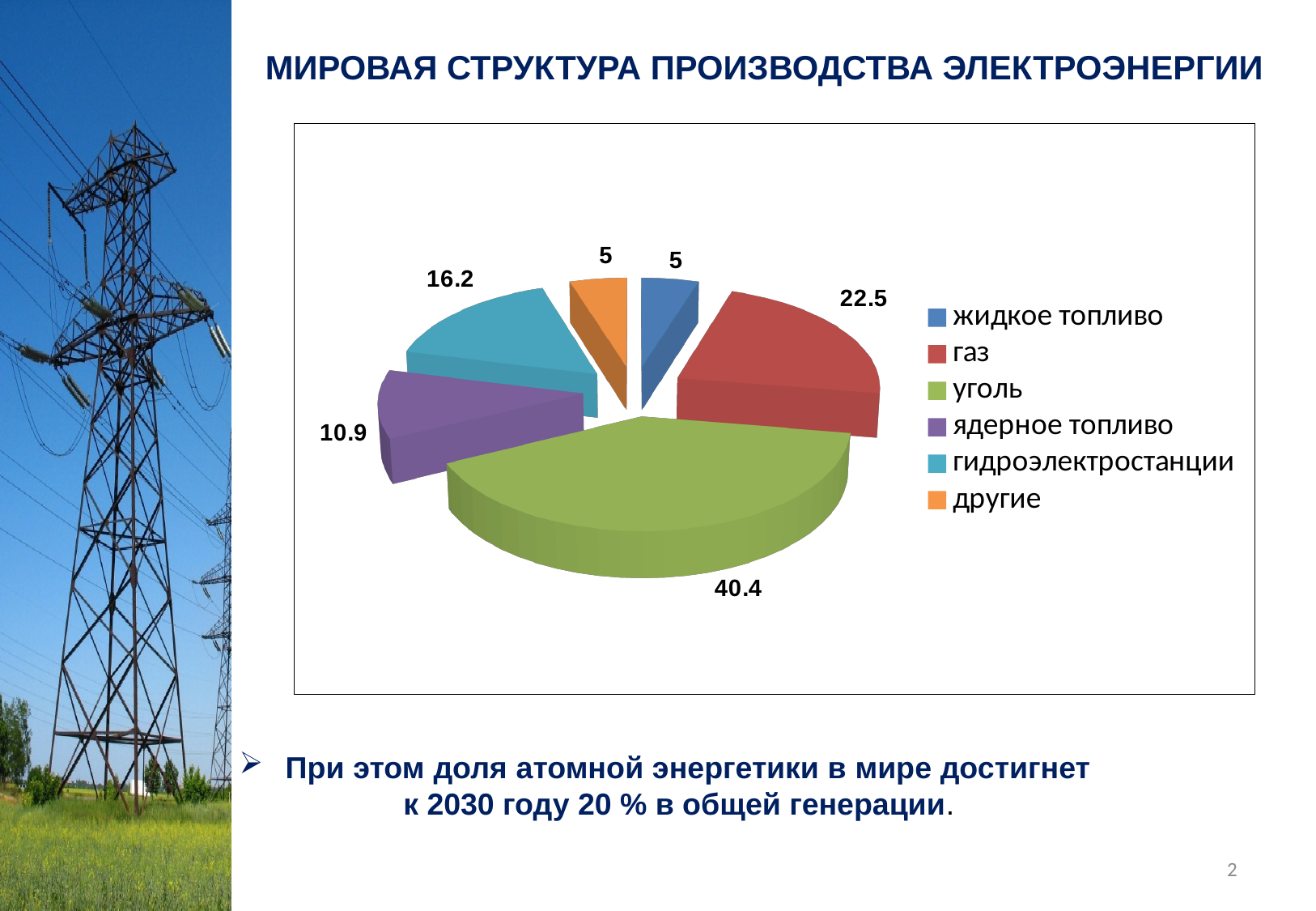
What is the value for газ? 22.5 What is the value for ядерное топливо? 10.9 Which category has the largest slice? уголь What is the value for гидроэлектростанции? 16.2 What is the value for уголь? 40.4 What kind of chart is shown on the slide? pie chart Which two categories share the same value of 5? жидкое топливо and другие What is the difference between the values for гидроэлектростанции and ядерное топливо? 5.3 What is the difference between the values for уголь and газ? 17.9 What colour is the slice for ядерное топливо? purple Which is larger, газ or гидроэлектростанции? газ How many categories does the pie chart have? 6